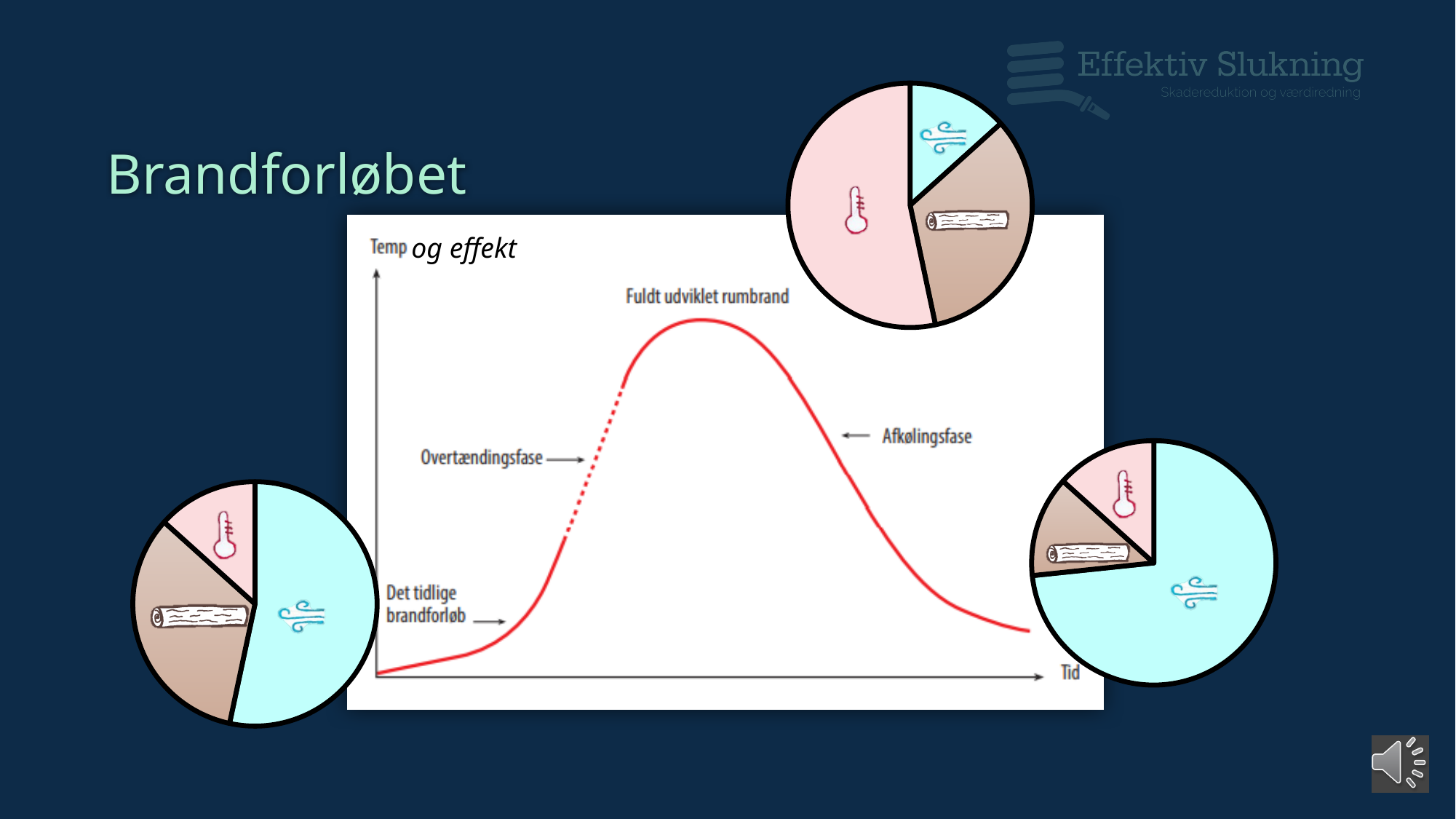
How many slices does each pie chart on the slide have? 3 How many pie charts are shown on the slide? 3 In the central line chart, does the curve rise or fall during the Afkølingsfase? fall What is the label on the horizontal axis of the central line chart? Tid In the central line chart, which labelled phase is at the peak of the curve? Fuldt udviklet rumbrand How many labelled phases are marked along the curve in the central line chart? 4 What is the label on the vertical axis of the central line chart? Temp og effekt In the pie chart at the bottom right of the slide, which slice is the largest: the thermometer, the wind or the log slice? wind What kind of chart is the large central chart on the slide? line chart In the central line chart, which labelled phase is at the lowest part of the curve, at the start? Det tidlige brandforløb In the central line chart, does the curve rise or fall between Det tidlige brandforløb and Fuldt udviklet rumbrand? rise In the pie chart at the top right of the slide, which slice is the largest: the thermometer, the wind or the log slice? thermometer